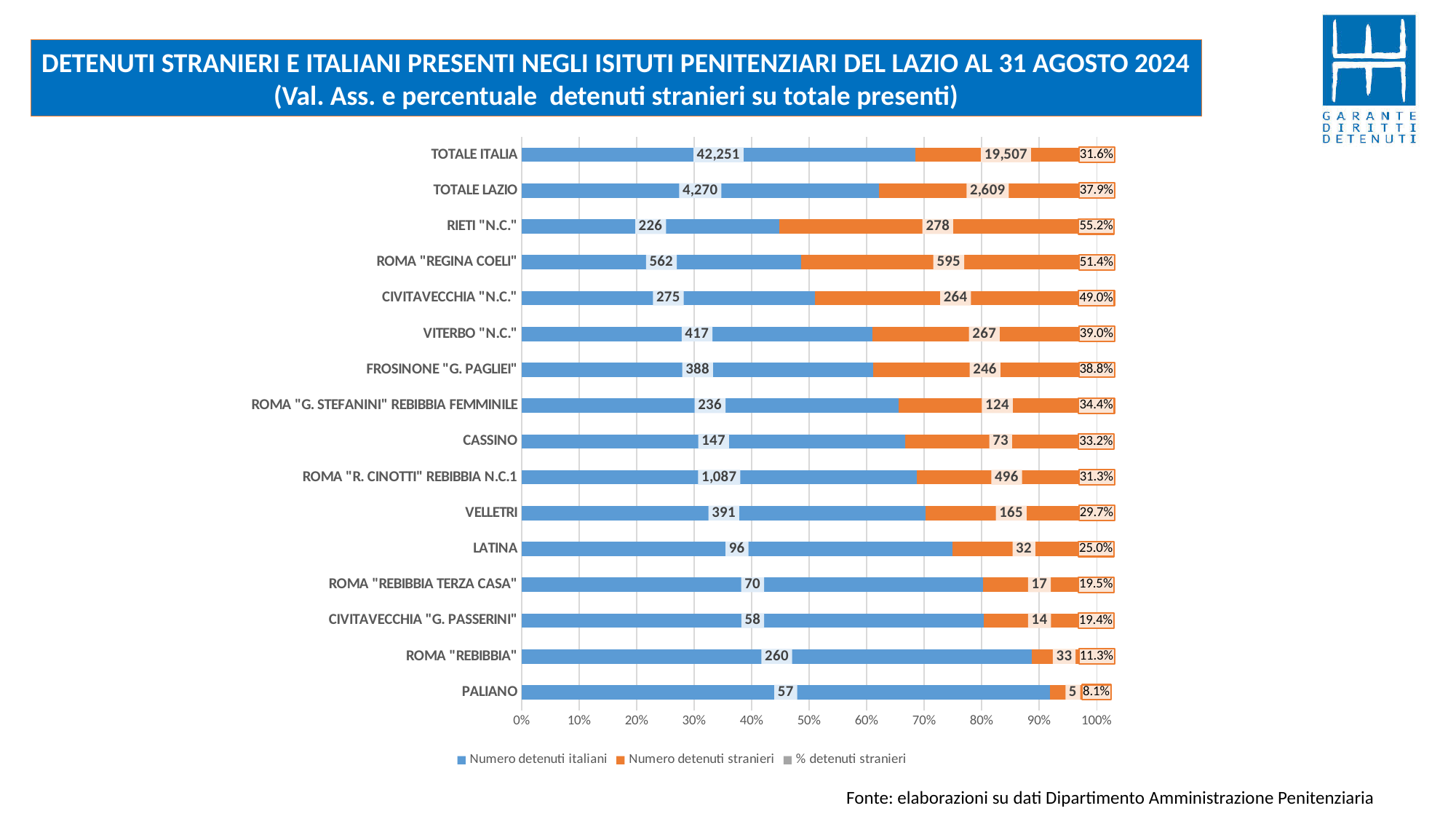
What is the Numero detenuti italiani value for RIETI "N.C."? 226 How many institutions or totals (categories) are plotted on the chart? 16 What is the % detenuti stranieri value for TOTALE ITALIA? 31.6% How many series does the legend list? 3 What is the source cited below the chart? Fonte: elaborazioni su dati Dipartimento Amministrazione Penitenziaria What is the total number of detainees (italiani plus stranieri) for CASSINO? 220 Which category has the highest % detenuti stranieri? RIETI "N.C." Which category has the lowest % detenuti stranieri? PALIANO What is the difference between Numero detenuti italiani and Numero detenuti stranieri for TOTALE LAZIO? 1,661 What is the Numero detenuti stranieri value for ROMA "REGINA COELI"? 595 Which has more Numero detenuti italiani: ROMA "R. CINOTTI" REBIBBIA N.C.1 or ROMA "REBIBBIA"? ROMA "R. CINOTTI" REBIBBIA N.C.1 What kind of chart is shown on the slide? Stacked bar chart